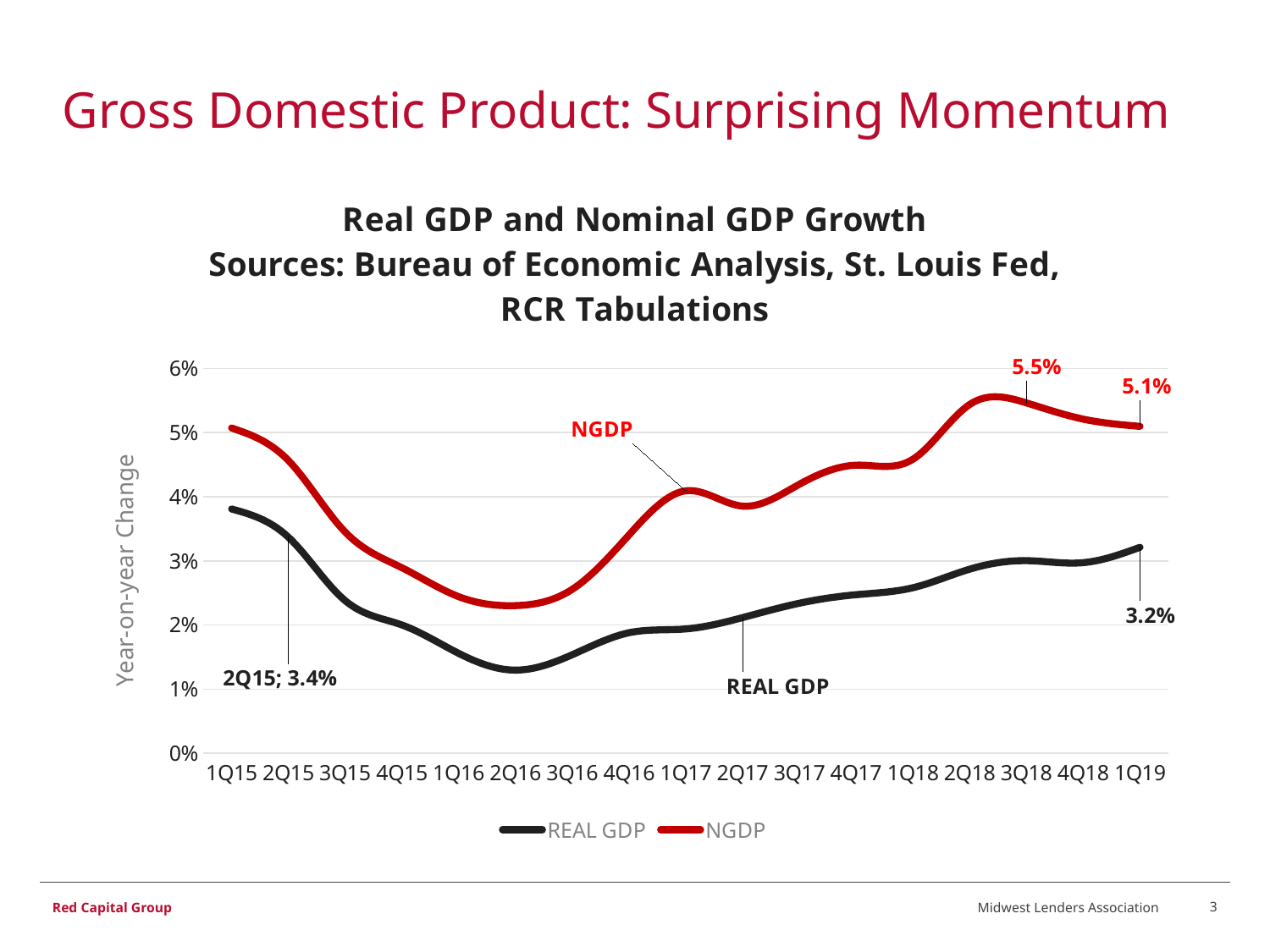
What kind of chart is shown on the slide? line chart How many series does the legend list? 2 In which quarter does the NGDP line reach its highest value? 3Q18 What is the Real GDP growth value labelled at 2Q15? 3.4% Is the Real GDP value at 2Q16 greater or less than 2%? less What is the difference between the NGDP and Real GDP values labelled at 1Q19? 1.9 percentage points At 1Q19, which series has the larger value, NGDP or Real GDP? NGDP How many quarters are shown on the x axis? 17 What is the NGDP growth value labelled at 1Q19? 5.1% In which quarter does the Real GDP line reach its lowest value? 2Q16 What is the Real GDP growth value labelled at 1Q19? 3.2% What is the peak NGDP value labelled on the chart? 5.5%